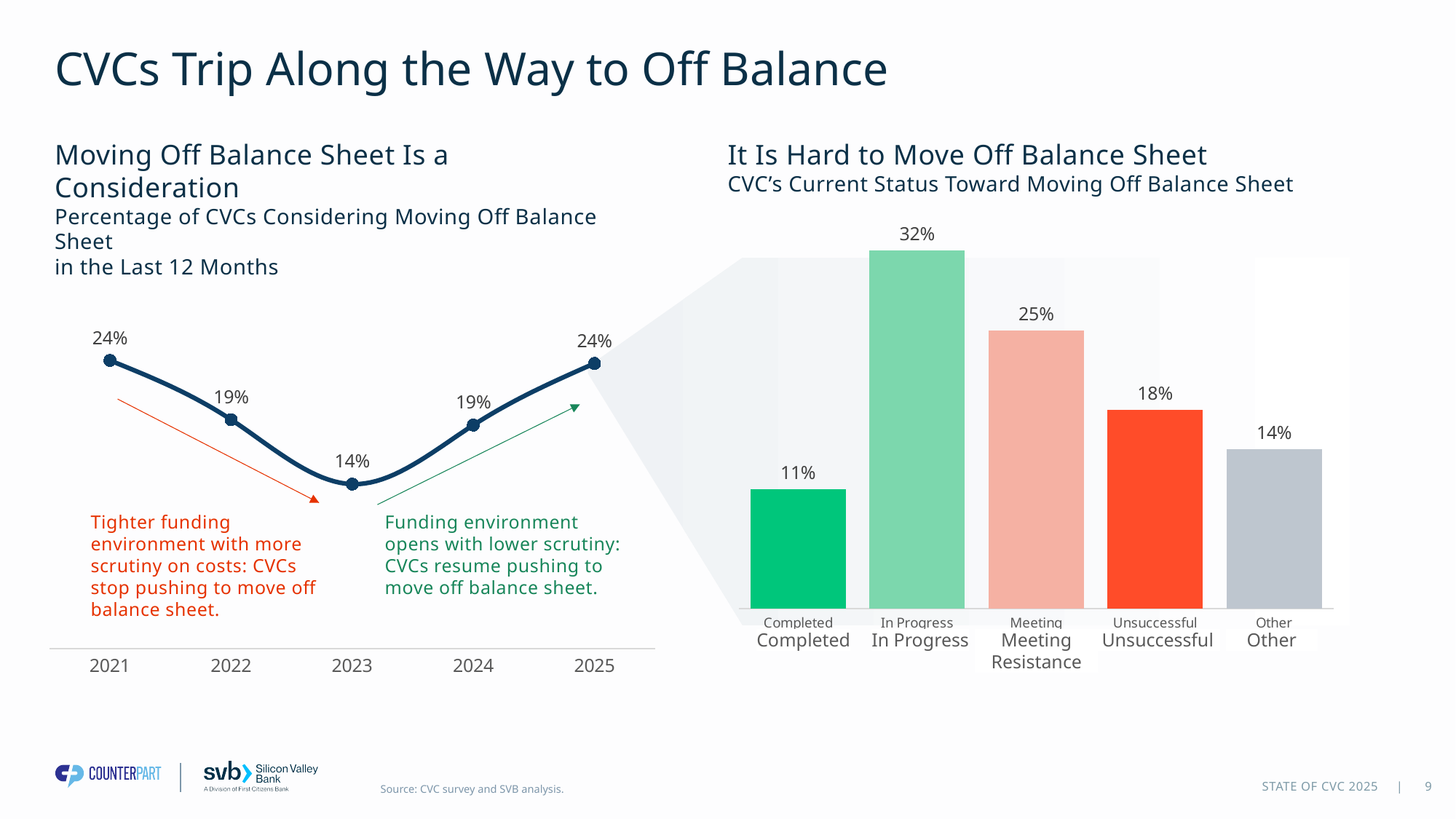
In the right chart (It Is Hard to Move Off Balance Sheet), what is the difference between In Progress and Unsuccessful? 14 percentage points In the left chart (Moving Off Balance Sheet Is a Consideration), what is the difference between the 2021 value and the 2023 value? 10 percentage points In the right chart (It Is Hard to Move Off Balance Sheet), which category has the highest value? In Progress In the right chart (It Is Hard to Move Off Balance Sheet), what is the value for Meeting Resistance? 25% In the left chart (Moving Off Balance Sheet Is a Consideration), what kind of chart is shown? Line chart In the left chart (Moving Off Balance Sheet Is a Consideration), what is the value for 2025? 24% In the left chart (Moving Off Balance Sheet Is a Consideration), do the values rise or fall from 2023 to 2025? Rise In the left chart (Moving Off Balance Sheet Is a Consideration), what percentage of CVCs were considering moving off balance sheet in 2023? 14% In the right chart (It Is Hard to Move Off Balance Sheet), which category has the lowest value? Completed In the right chart (It Is Hard to Move Off Balance Sheet), which is larger, Unsuccessful or Other? Unsuccessful In the left chart (Moving Off Balance Sheet Is a Consideration), which year has the lowest value? 2023 In the left chart (Moving Off Balance Sheet Is a Consideration), how many years are plotted? 5